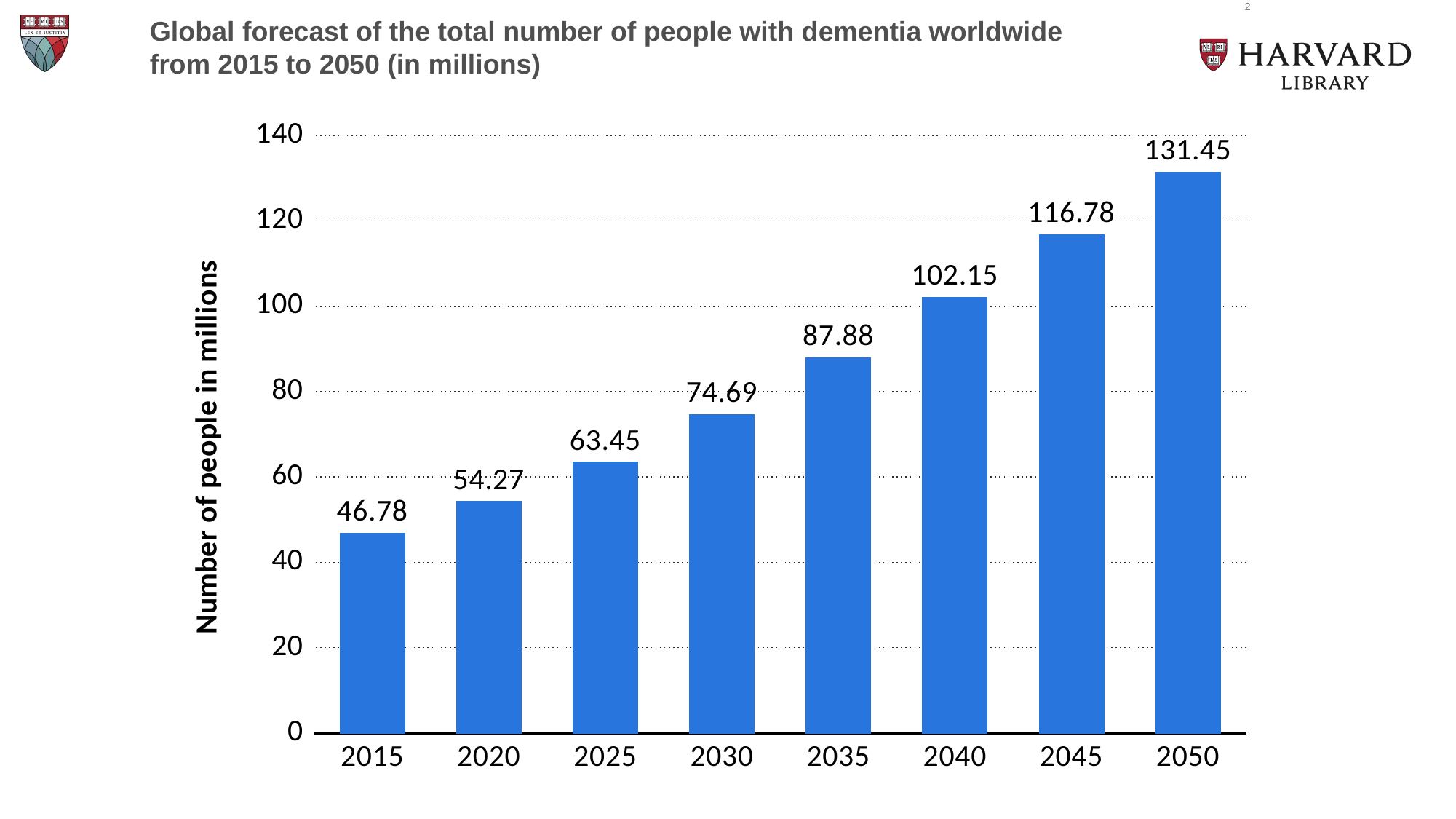
What is the difference between the 2050 and 2015 values? 84.67 How many years are shown on the x axis? 8 Which year has the highest forecast number of people with dementia? 2050 What is the difference between the 2040 and 2035 values? 14.27 Which is larger, the value for 2025 or the value for 2035? 2035 Is the value for 2040 greater or less than 100? greater What is the forecast number of people with dementia in 2045? 116.78 What is the forecast number of people with dementia in 2030? 74.69 Do the values rise or fall from 2015 to 2050? rise Which year has the lowest forecast number of people with dementia? 2015 What is the label of the vertical axis? Number of people in millions What kind of chart is shown on the slide? bar chart